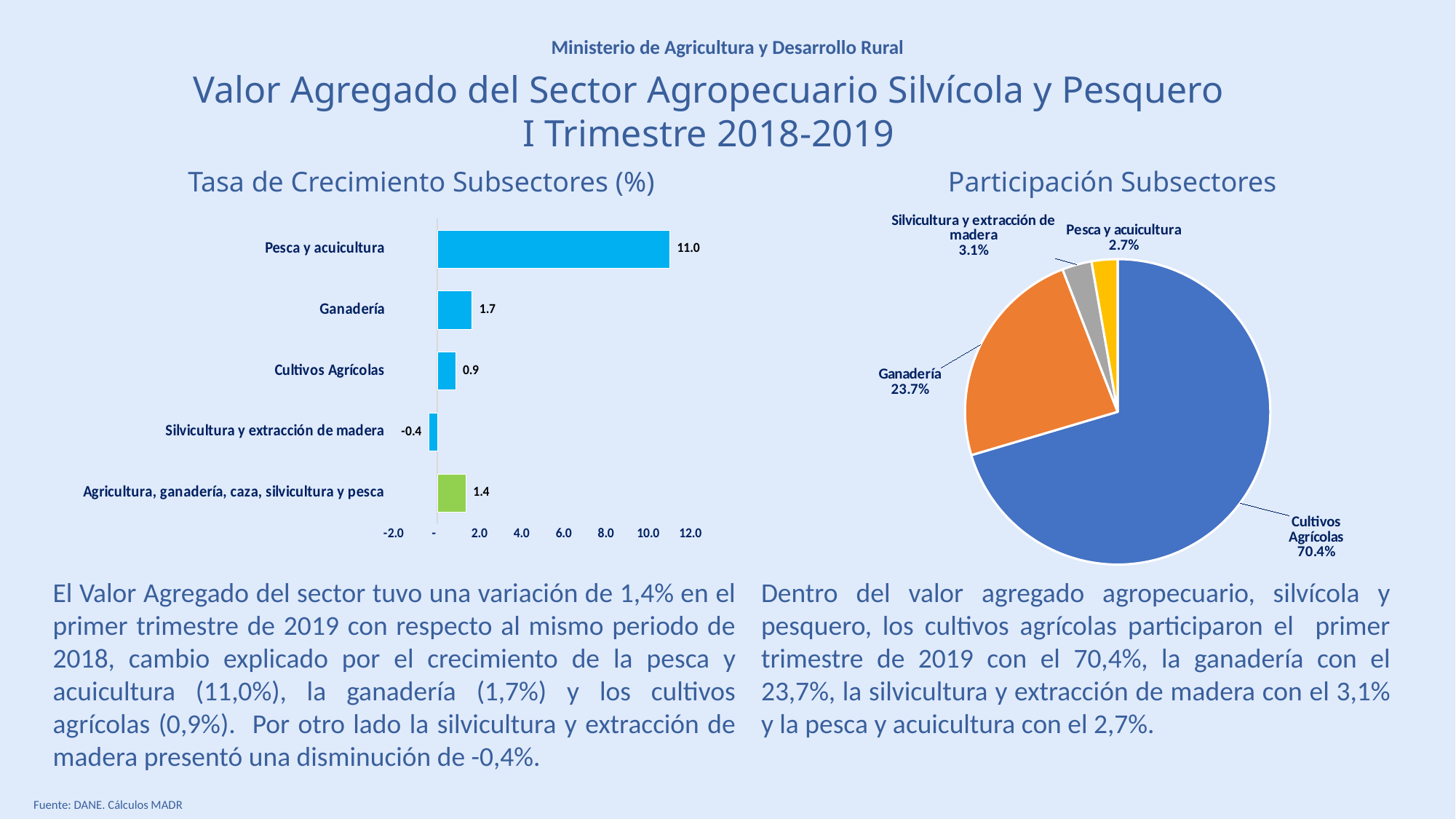
In the 'Tasa de Crecimiento Subsectores (%)' chart, what is the difference between the values for Ganadería and Cultivos Agrícolas? 0.8 How many categories are shown in the 'Tasa de Crecimiento Subsectores (%)' chart? 5 In the 'Tasa de Crecimiento Subsectores (%)' chart, which category has the lowest value? Silvicultura y extracción de madera What kind of chart is 'Tasa de Crecimiento Subsectores (%)'? Bar chart In the 'Participación Subsectores' chart, which slice is the smallest? Pesca y acuicultura In the 'Participación Subsectores' chart, what is the value for Ganadería? 23.7% In the 'Tasa de Crecimiento Subsectores (%)' chart, what is the value for Pesca y acuicultura? 11.0 In the 'Participación Subsectores' chart, what share does Cultivos Agrícolas have? 70.4% In the 'Tasa de Crecimiento Subsectores (%)' chart, which is larger: Ganadería or Agricultura, ganadería, caza, silvicultura y pesca? Ganadería What kind of chart is 'Participación Subsectores'? Pie chart In the 'Tasa de Crecimiento Subsectores (%)' chart, which category has the highest value? Pesca y acuicultura In the 'Tasa de Crecimiento Subsectores (%)' chart, what is the value for Silvicultura y extracción de madera? -0.4